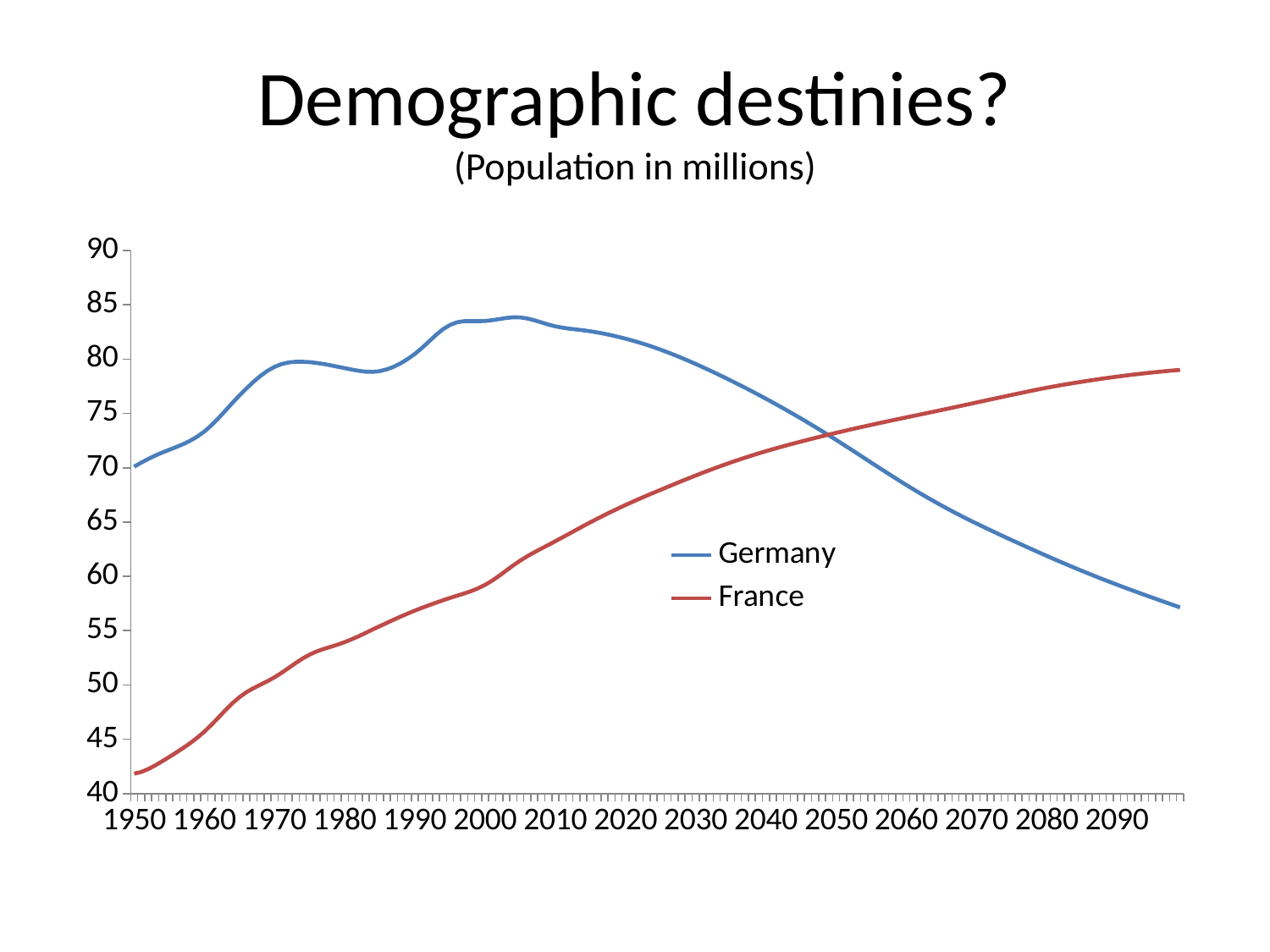
Is the value for Germany in 1950 greater or less than 65? greater Which colour is used for the Germany line? blue What kind of chart is shown on the slide? line chart Is the value for France in 2090 greater or less than 75? greater Is the value for France in 1950 greater or less than 45? less Does the France line rise or fall from 1950 to 2090? rise In 1950, which is larger, the value for Germany or the value for France? Germany How many series does the legend list? 2 What is the title of the chart on the slide? Demographic destinies? In 2090, which is larger, the value for Germany or the value for France? France